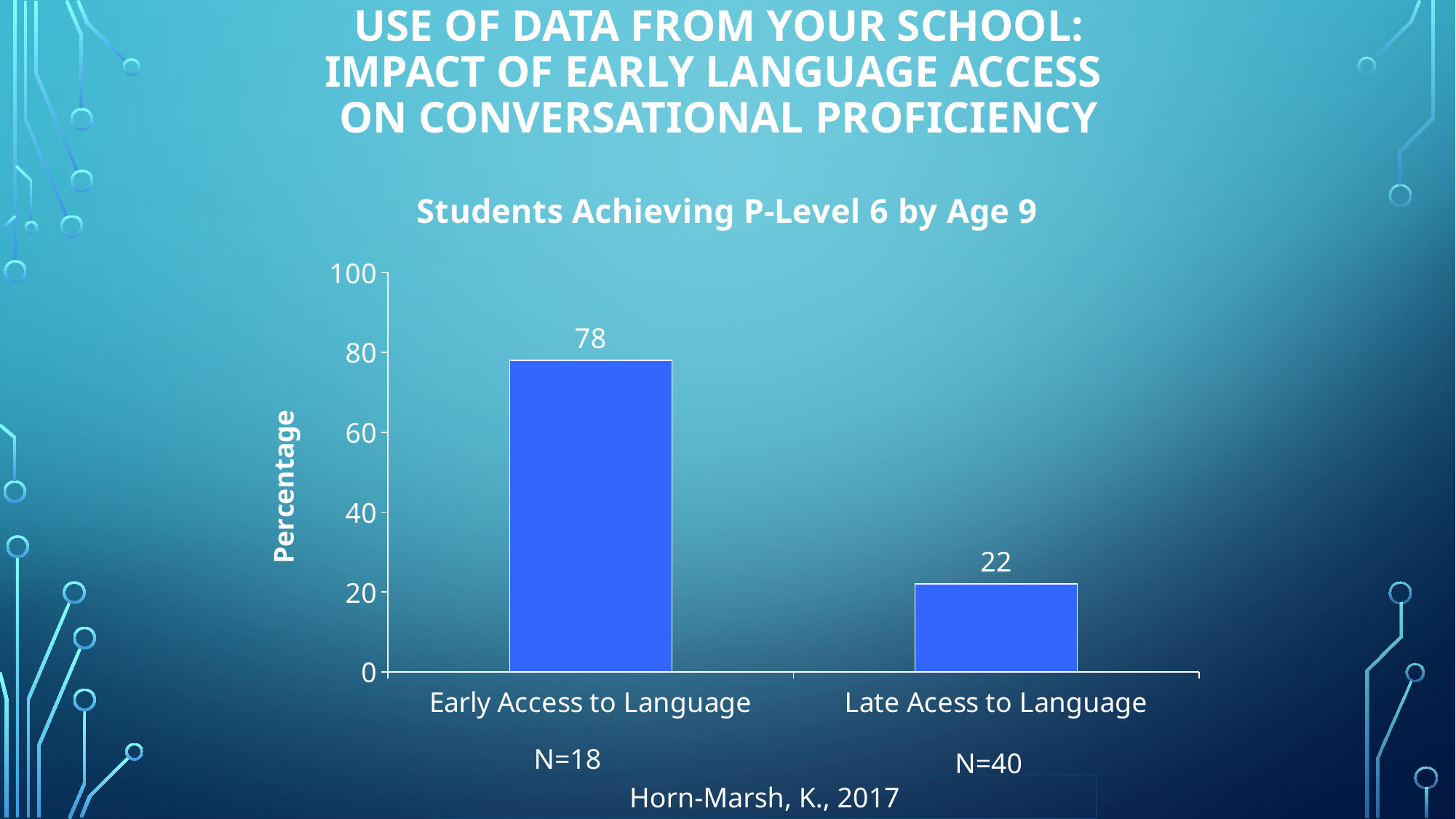
Is the value for Late Acess to Language greater or less than 40? less What is the label of the vertical axis? Percentage Which category has the lowest value? Late Acess to Language What is the value for Early Access to Language? 78 What is the value for Late Acess to Language? 22 Which is larger, the value for Early Access to Language or the value for Late Acess to Language? Early Access to Language Is the value for Early Access to Language greater or less than 60? greater What kind of chart is shown on the slide? bar chart What is the title of the chart? Students Achieving P-Level 6 by Age 9 Which category has the highest value? Early Access to Language How many categories are shown on the x axis? 2 What is the difference between the values for Early Access to Language and Late Acess to Language? 56